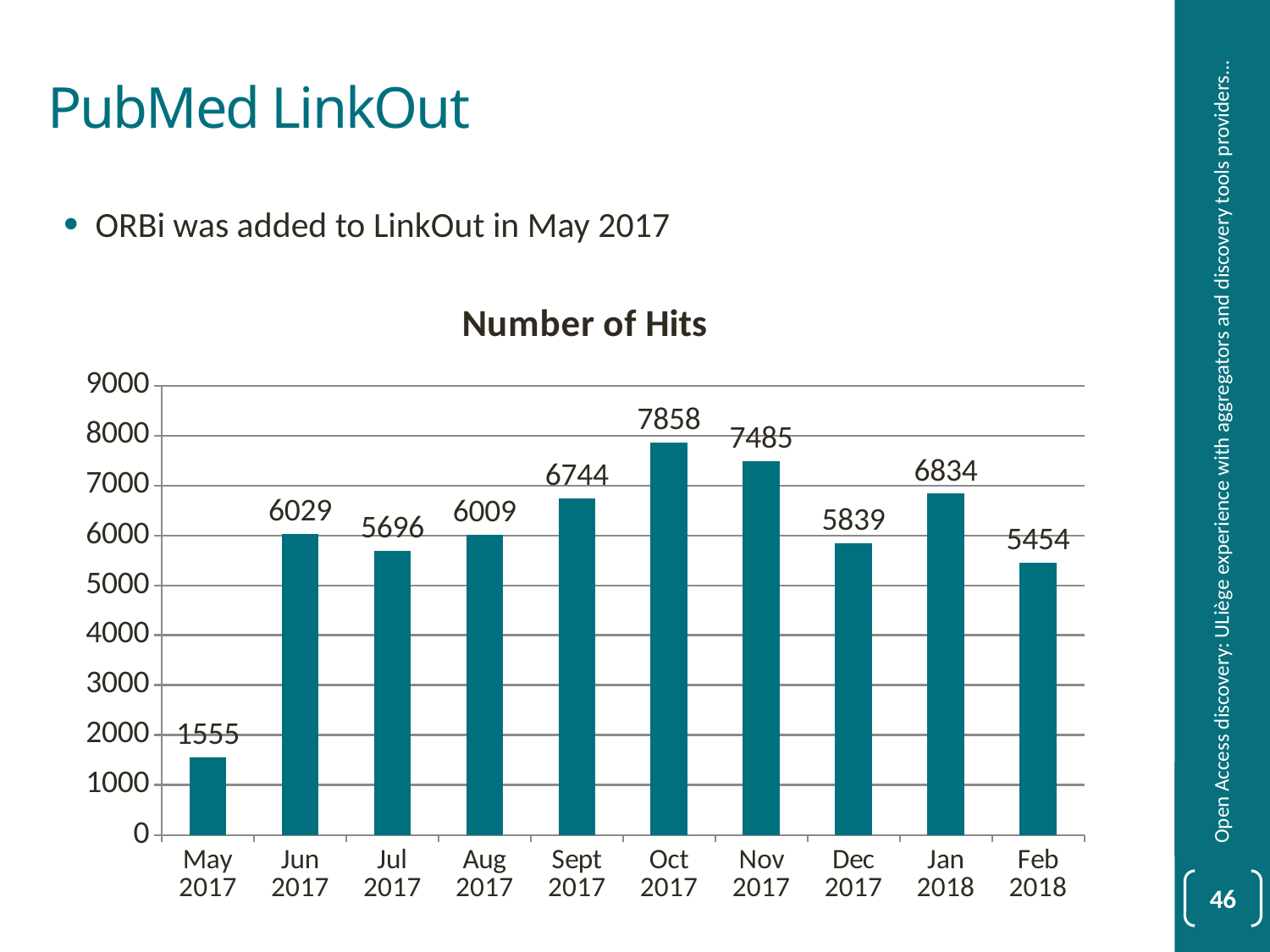
What is the number of hits for May 2017? 1555 Which month has the lowest number of hits? May 2017 What is the number of hits for Jan 2018? 6834 Do the hits rise or fall from Nov 2017 to Dec 2017? fall Which month has the highest number of hits? Oct 2017 What is the number of hits for Oct 2017? 7858 Is the value for Dec 2017 greater or less than 6000? less How many months are shown on the x axis? 10 What is the title of the chart? Number of Hits Which has more hits, Jul 2017 or Aug 2017? Aug 2017 What is the difference in hits between Oct 2017 and Nov 2017? 373 What kind of chart is shown? bar chart